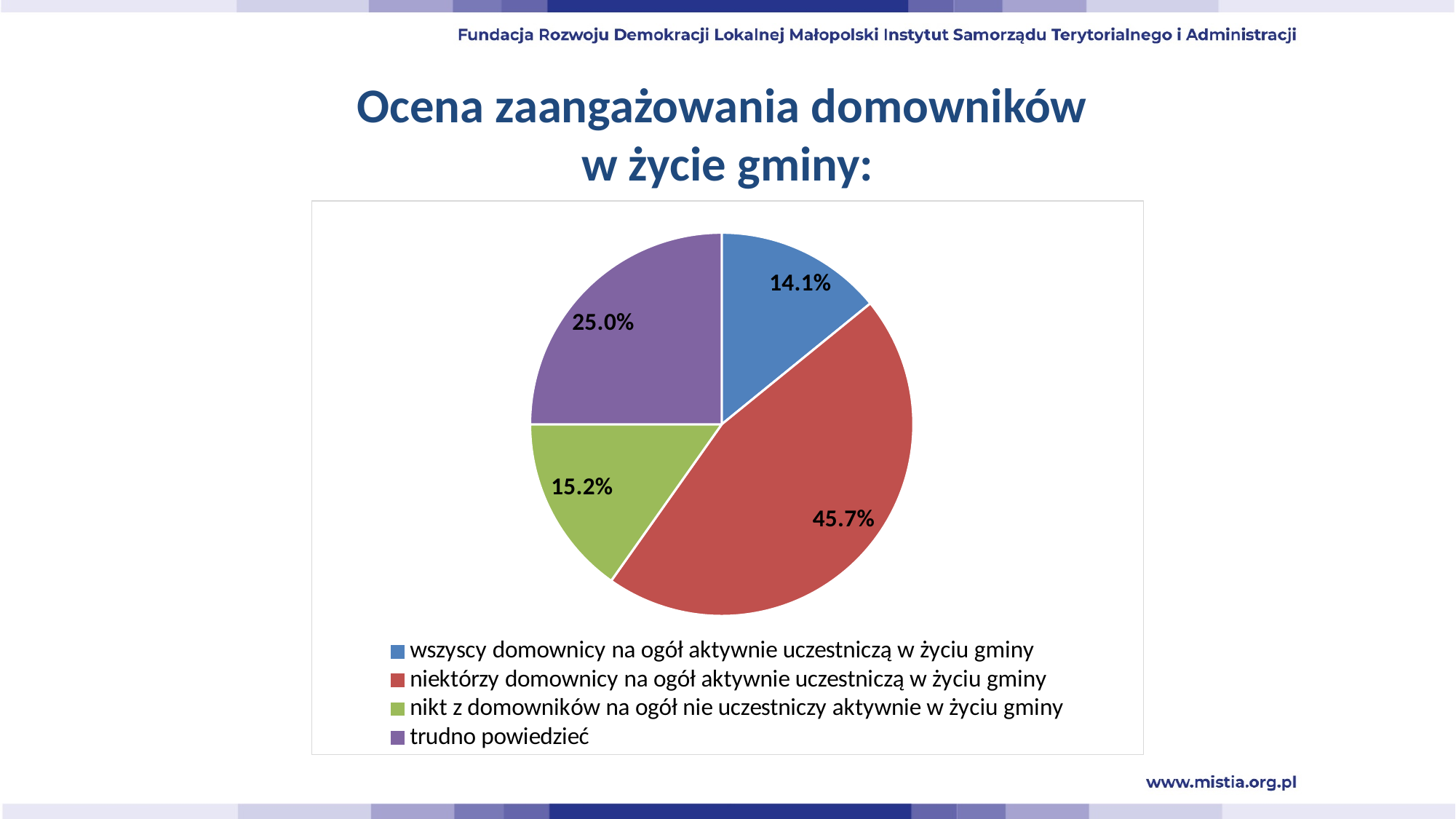
How many categories does the pie chart have? 4 What kind of chart is shown on the slide? pie chart What share of the pie is labelled 'wszyscy domownicy na ogół aktywnie uczestniczą w życiu gminy'? 14.1% What colour is the slice for 'trudno powiedzieć'? purple What is the title of the slide above the chart? Ocena zaangażowania domowników w życie gminy: What share of the pie is labelled 'nikt z domowników na ogół nie uczestniczy aktywnie w życiu gminy'? 15.2% What is the difference in percentage points between the 'niektórzy domownicy' slice and the 'trudno powiedzieć' slice? 20.7 Which category has the largest slice of the pie? niektórzy domownicy na ogół aktywnie uczestniczą w życiu gminy What share of the pie is labelled 'trudno powiedzieć'? 25.0% What share of the pie is labelled 'niektórzy domownicy na ogół aktywnie uczestniczą w życiu gminy'? 45.7% Which category has the smallest slice of the pie? wszyscy domownicy na ogół aktywnie uczestniczą w życiu gminy Which is larger: the 'trudno powiedzieć' slice or the 'nikt z domowników' slice? trudno powiedzieć